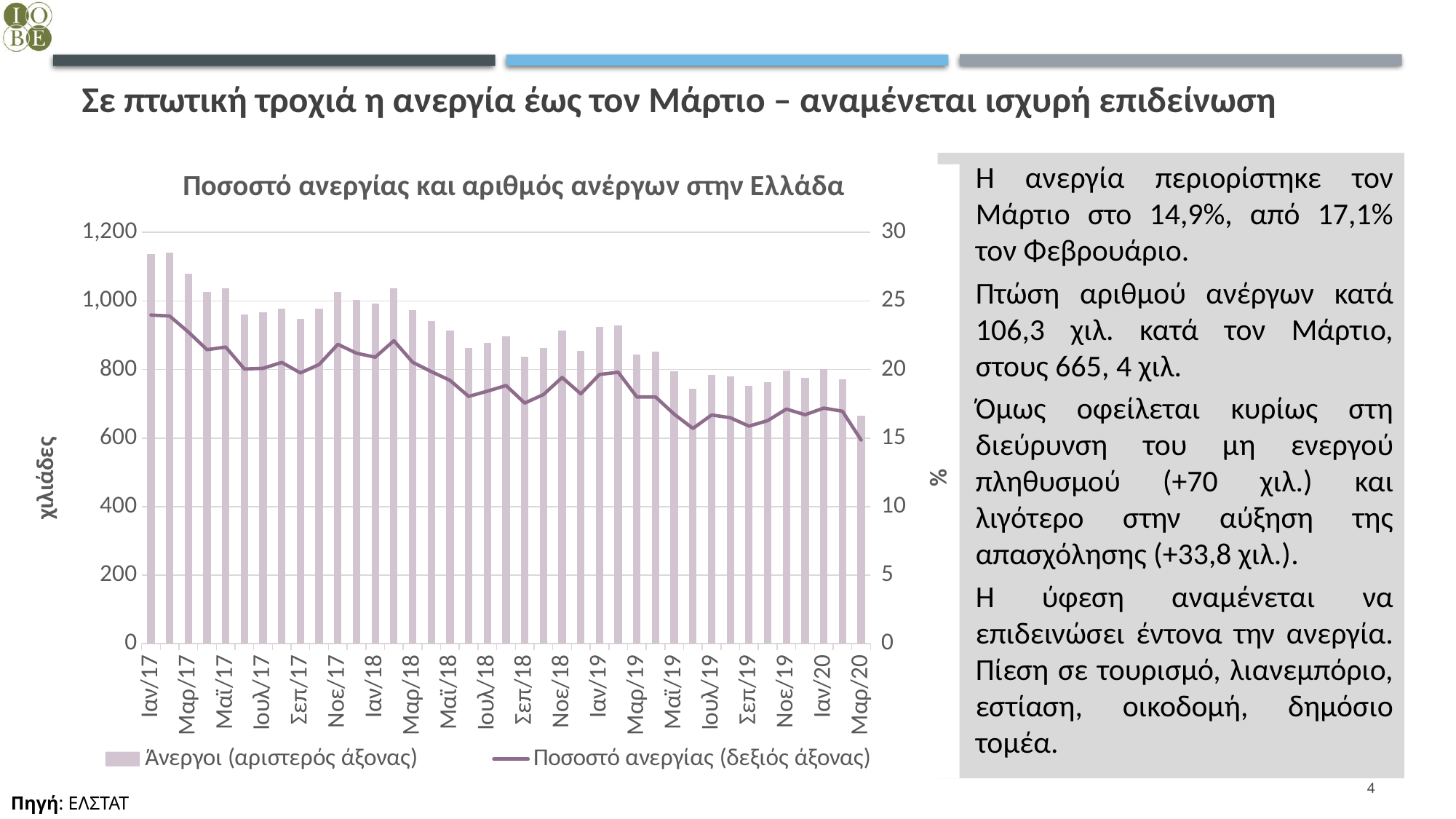
Is the number of unemployed (bar) for Ιαν/17 greater or less than 1,000 thousand? greater Which series is plotted as bars according to the legend? Άνεργοι (αριστερός άξονας) Which month has the lowest number of unemployed (bar) in the chart? Μαρ/20 Which month has the lowest unemployment rate (line) in the chart? Μαρ/20 Does the unemployment rate line generally rise or fall from Ιαν/17 to Μαρ/20? fall Is the number of unemployed (bar) for Μαρ/20 greater or less than 800 thousand? less Is the unemployment rate (line) for Ιαν/17 greater or less than 20%? greater How many series does the chart legend list? 2 What is the title of the chart? Ποσοστό ανεργίας και αριθμός ανέργων στην Ελλάδα What kind of chart is shown on the slide? Combined bar and line chart Which is larger, the number of unemployed in Ιαν/18 or in Ιαν/20? Ιαν/18